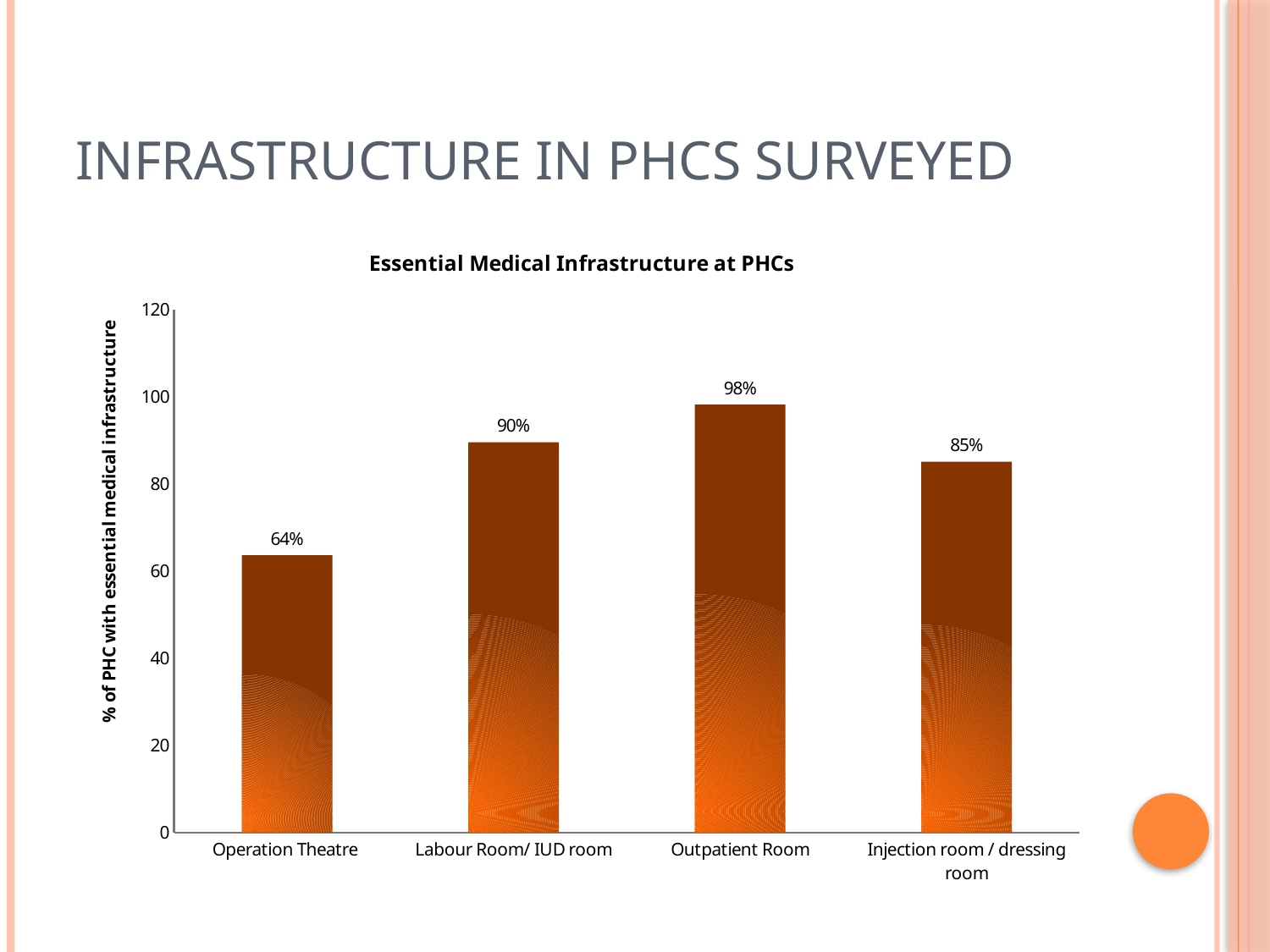
What is the value for Labour Room/ IUD room? 90% What kind of chart is shown on the slide? bar chart What is the title of the chart? Essential Medical Infrastructure at PHCs Which category has the highest value? Outpatient Room Which is larger, the value for Labour Room/ IUD room or the value for Injection room / dressing room? Labour Room/ IUD room What is the difference between the values for Outpatient Room and Operation Theatre? 34% What is the value for Injection room / dressing room? 85% How many categories are shown on the x axis? 4 Which category has the lowest value? Operation Theatre Is the value for Operation Theatre greater or less than 80? less What is the value for Operation Theatre? 64% What is the value for Outpatient Room? 98%